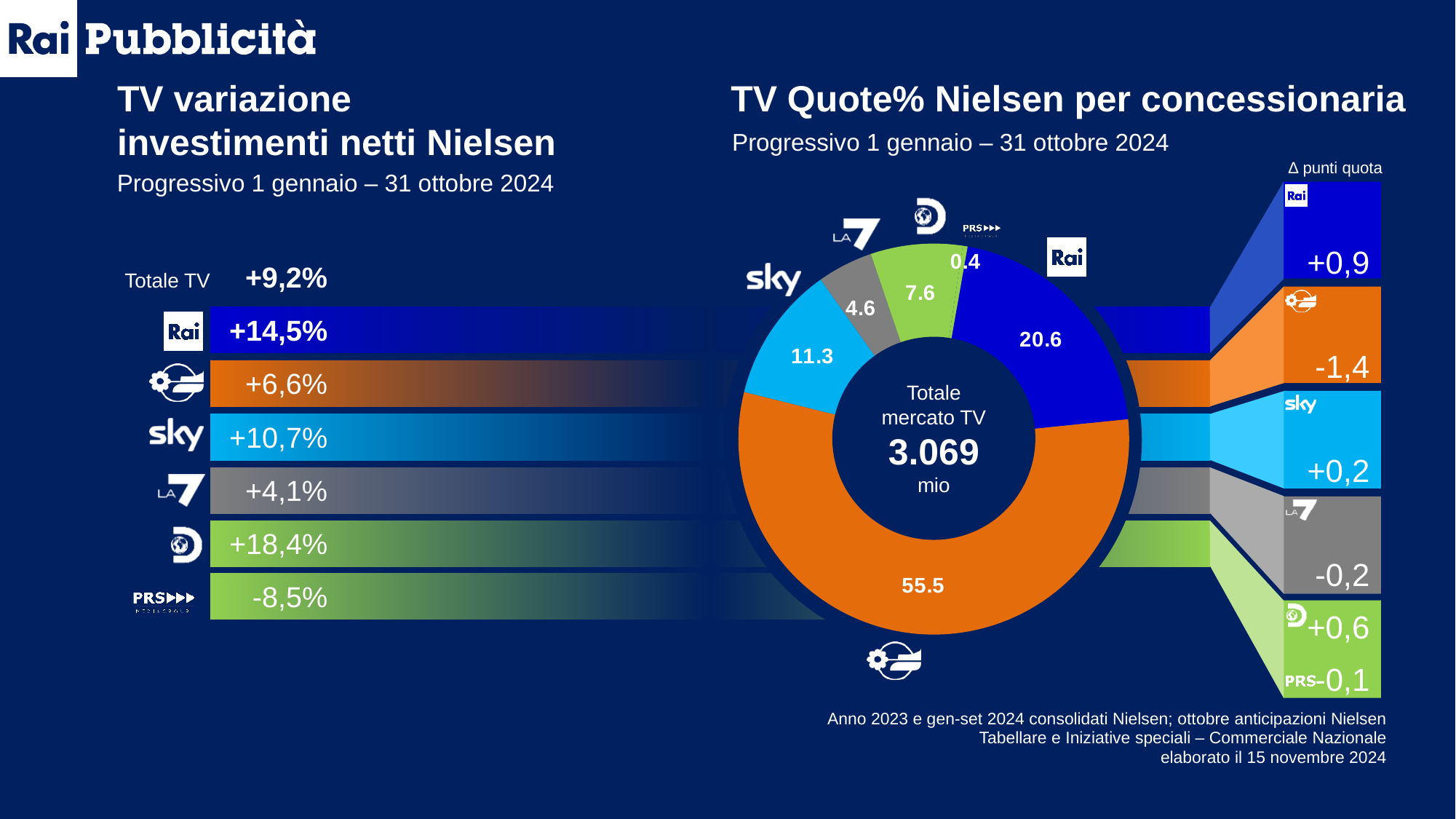
In the 'TV variazione investimenti netti Nielsen' chart, which is larger, the value for Rai or the value for La7? Rai In the 'TV variazione investimenti netti Nielsen' chart, what is the value for Sky? +10,7% In the 'TV Quote% Nielsen per concessionaria' chart, what is the share for Rai? 20.6 In the 'TV Quote% Nielsen per concessionaria' chart, what is the Δ punti quota value for La7? -0,2 In the 'TV variazione investimenti netti Nielsen' chart, what is the value for Rai? +14,5% In the 'TV variazione investimenti netti Nielsen' chart, what is the value shown for Totale TV? +9,2% In the 'TV Quote% Nielsen per concessionaria' chart, what is the total TV market value shown in the centre of the donut? 3.069 mio In the 'TV variazione investimenti netti Nielsen' chart, which broadcaster has the lowest value? PRS In the 'TV variazione investimenti netti Nielsen' chart, what is the value for PRS? -8,5% In the 'TV variazione investimenti netti Nielsen' chart, what is the difference between the Rai value and the Sky value? 3,8 percentage points In the 'TV Quote% Nielsen per concessionaria' chart, what is the largest share value shown? 55.5 In the 'TV Quote% Nielsen per concessionaria' chart, what is the share for Sky? 11.3